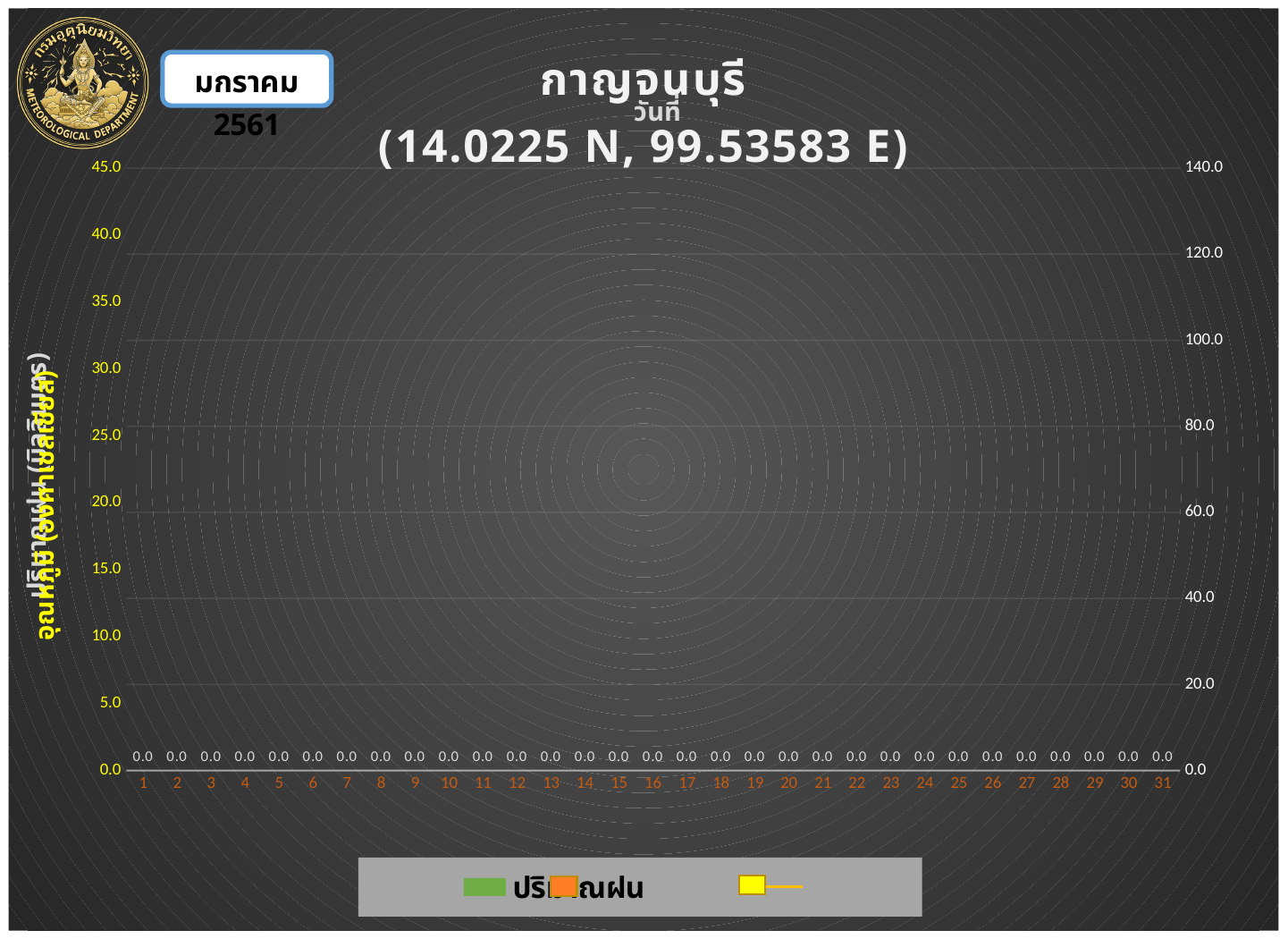
What is the highest tick value on the left vertical axis? 45.0 What is the value printed for day 15? 0.0 What is the value printed for day 1? 0.0 What coordinates are shown in the chart title? (14.0225 N, 99.53583 E) Do the printed values rise, fall, or stay flat from day 1 to day 31? stay flat What is the highest tick value on the right vertical axis? 140.0 How many days are shown along the x axis? 31 Is the value for day 5 greater or less than 5.0? less What is the difference between the values printed for day 10 and day 20? 0.0 What is the value printed for day 31? 0.0